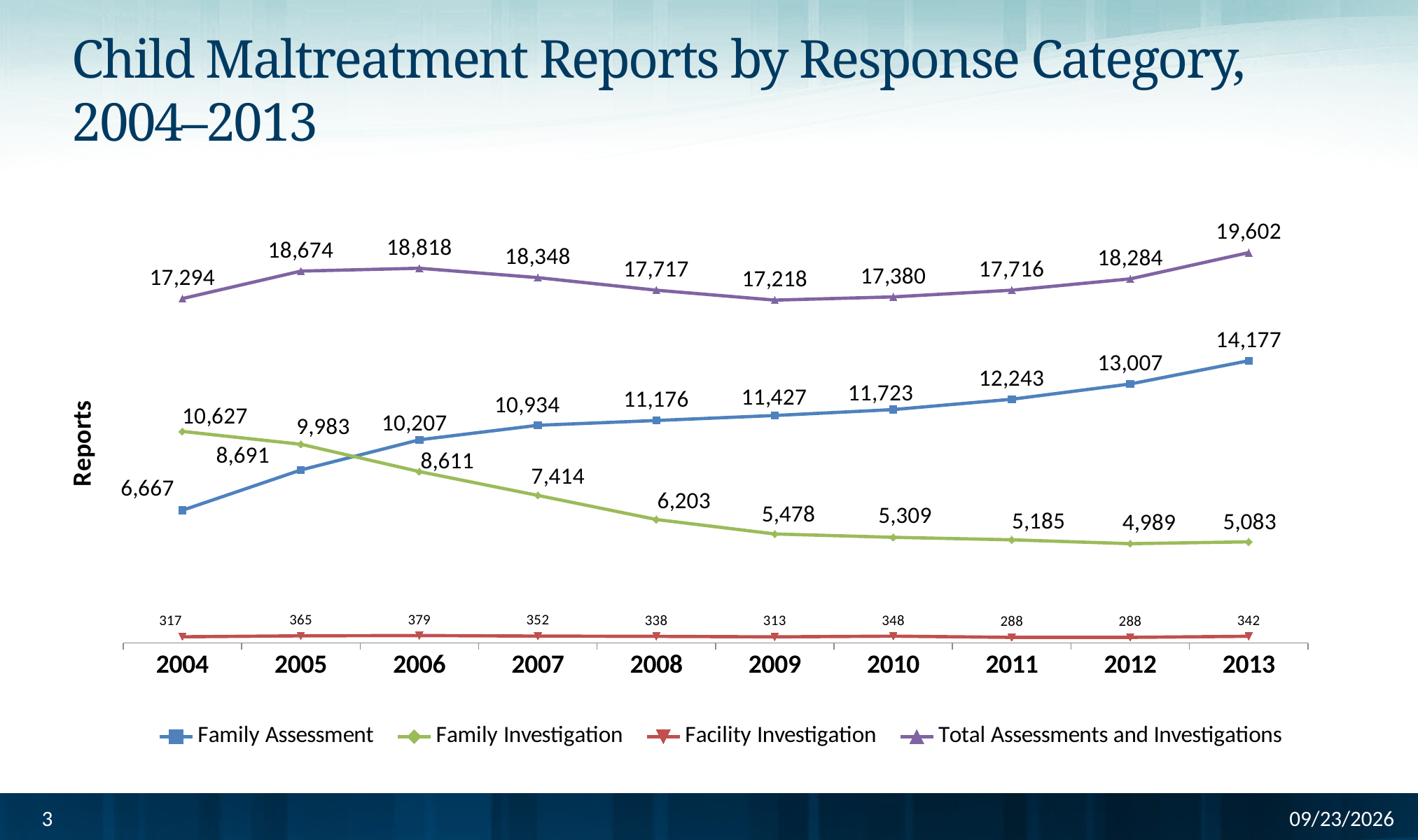
What kind of chart is shown on the slide? Line chart What is the value for Family Assessment in 2013? 14,177 In which year is Facility Investigation highest? 2006 In 2005, which is larger: Family Assessment or Family Investigation? Family Investigation Does Family Investigation rise or fall from 2004 to 2012? Fall By how much did Family Assessment increase from 2004 to 2013? 7,510 In which year is Family Investigation lowest? 2012 What is the value for Family Investigation in 2008? 6,203 How many years are shown on the x axis? 10 What is the value for Facility Investigation in 2006? 379 In which year is Total Assessments and Investigations highest? 2013 How many series does the legend list? 4